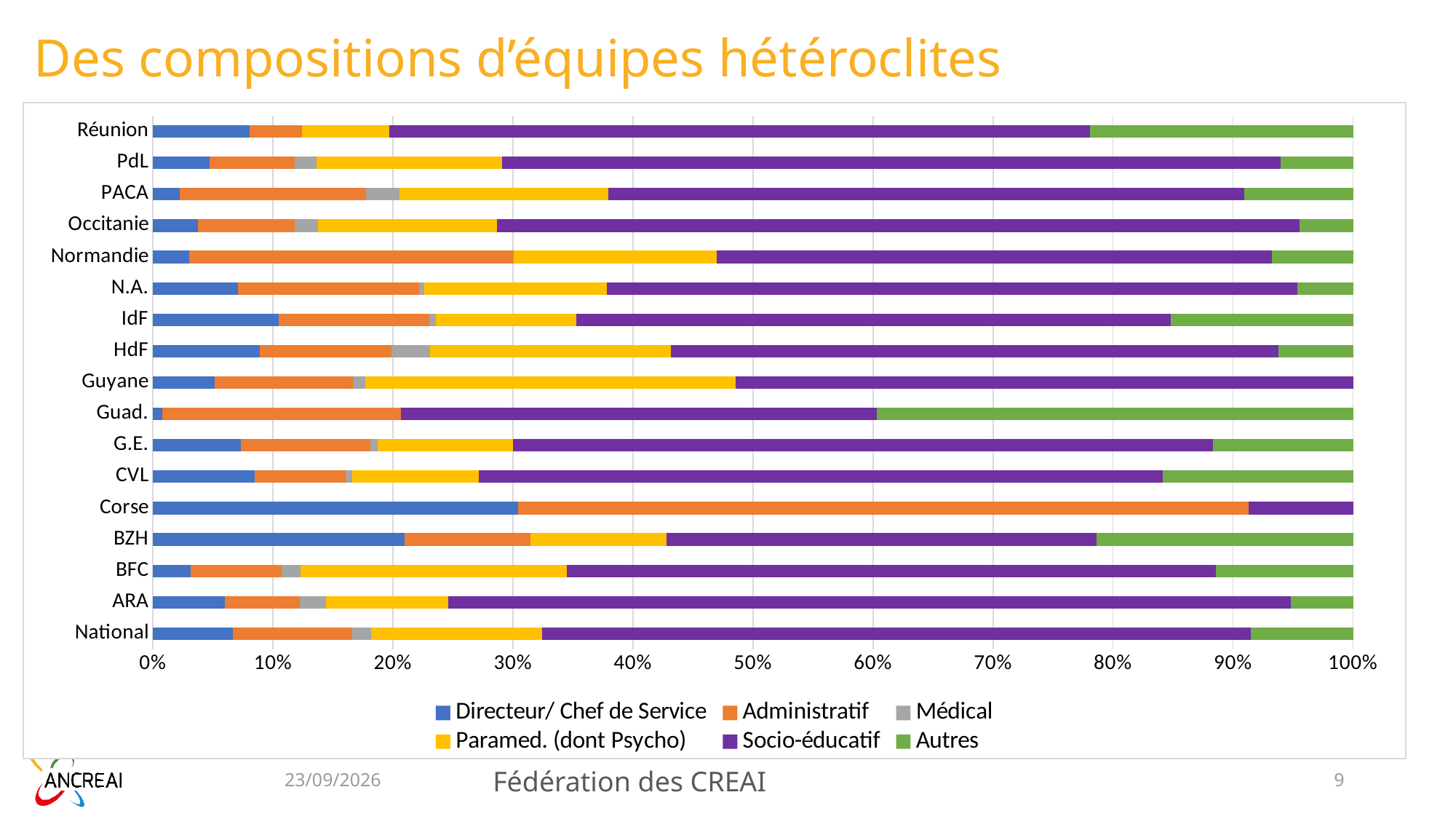
Which has the larger Directeur/ Chef de Service share, Corse or National? Corse Is the Directeur/ Chef de Service share for Corse greater or less than 20%? greater What kind of chart is shown on the slide? Stacked bar chart Is the Socio-éducatif share for Réunion greater or less than 50%? greater Which region has the largest Autres share? Guad. How many regions (categories) are listed on the vertical axis of the chart? 17 Which region has the largest Administratif share? Corse Which region has the largest Directeur/ Chef de Service share? Corse Which has the larger Administratif share, Normandie or Réunion? Normandie How many series does the chart legend list? 6 Is the Autres share for Guad. greater or less than 30%? greater What is the title of the slide containing the chart? Des compositions d’équipes hétéroclites